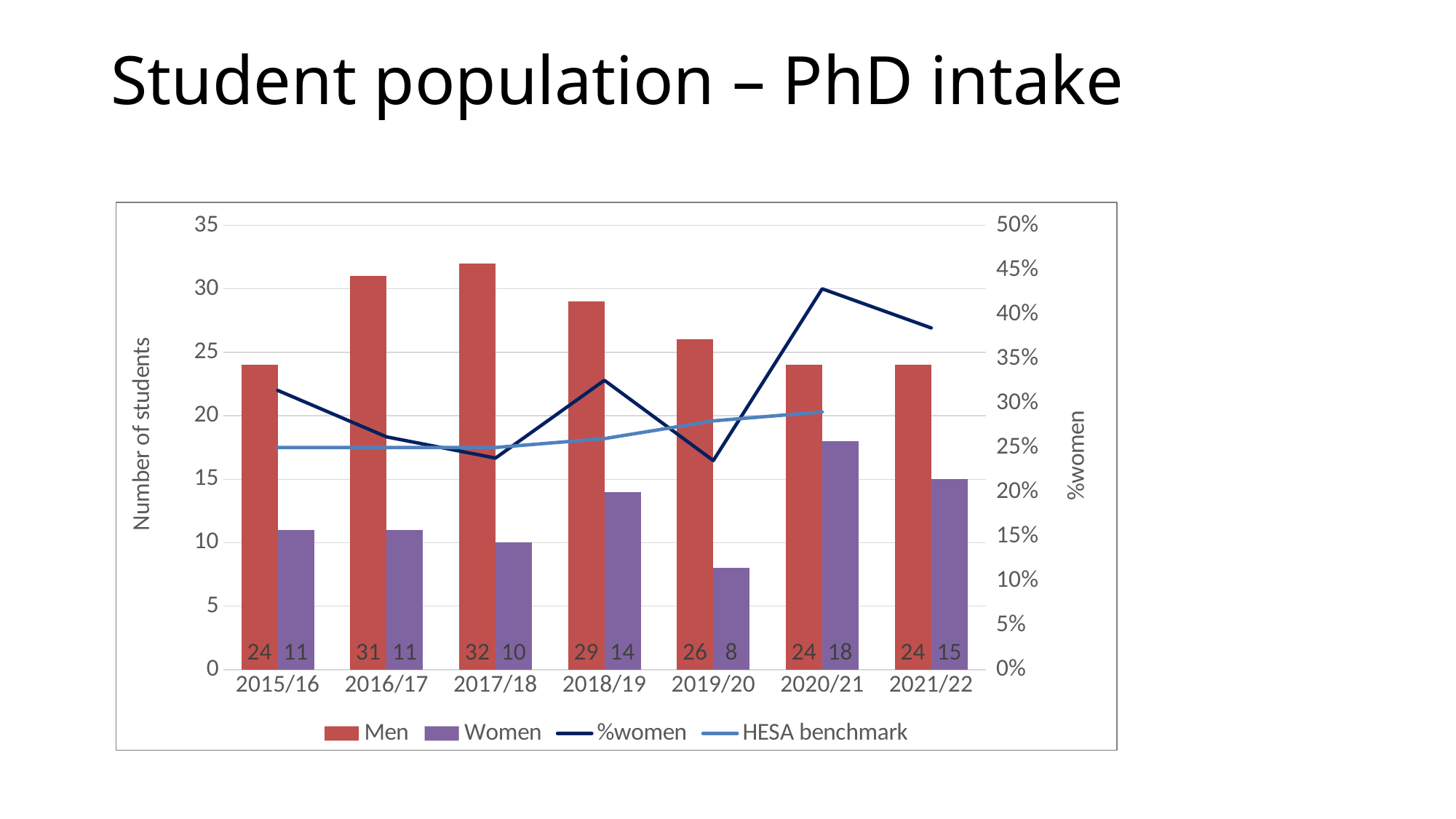
Is the HESA benchmark value for 2015/16 greater or less than 30%? less What is the difference between the number of men and the number of women in 2017/18? 22 In which year was the number of women lowest? 2019/20 How many series does the legend list? 4 In which year was the number of men highest? 2017/18 How many men were in the PhD intake in 2017/18? 32 What is the total number of students (men plus women) in 2020/21? 42 Is the %women value for 2020/21 greater or less than 40%? greater How many academic years are shown on the x axis? 7 Does the number of men rise or fall from 2017/18 to 2021/22? fall Which is larger: the number of women in 2018/19 or in 2021/22? 2021/22 How many women were in the PhD intake in 2020/21? 18